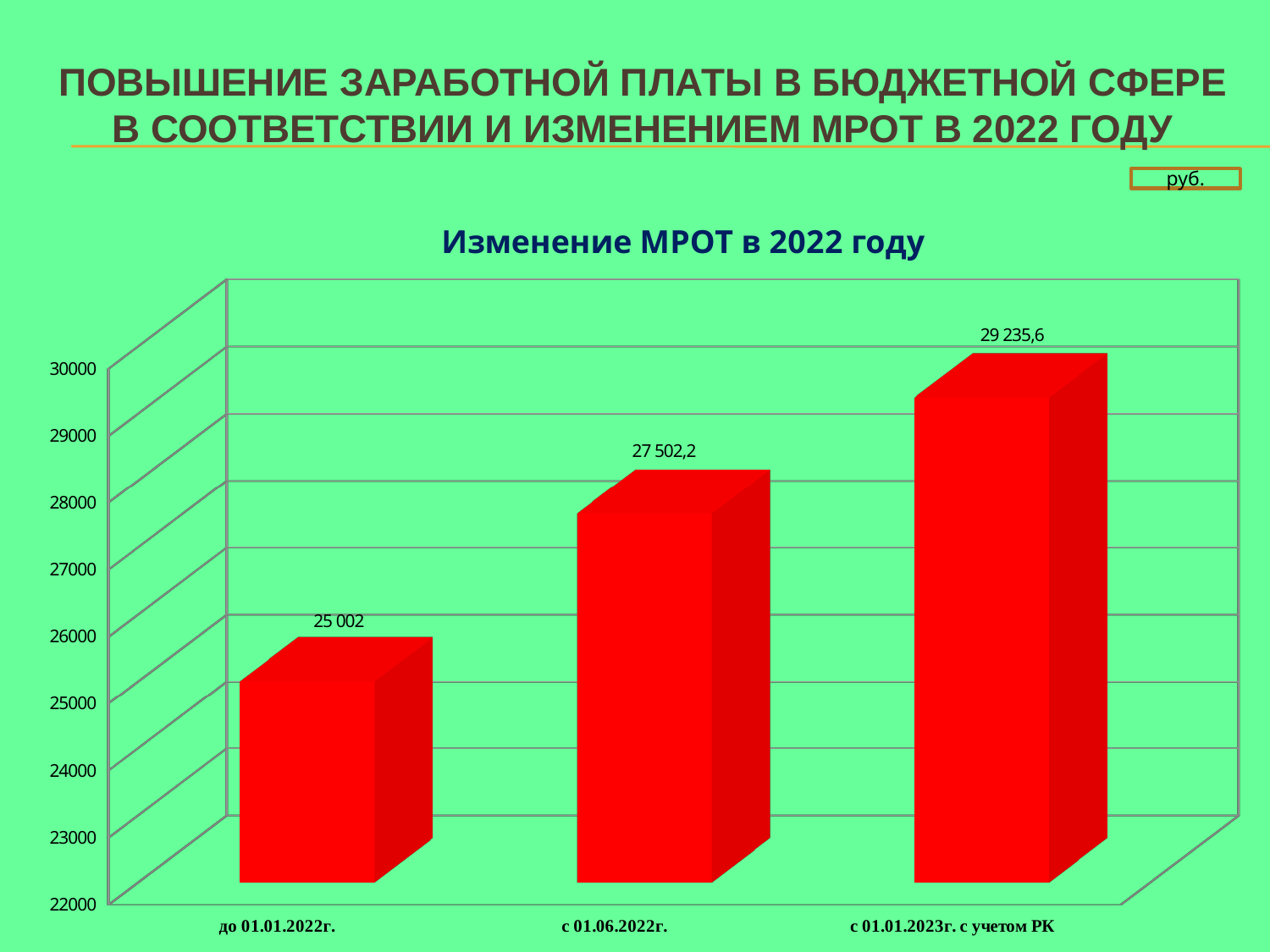
What is the difference between the values for "с 01.01.2023г. с учетом РК" and "с 01.06.2022г."? 1 733,4 What is the value for "с 01.01.2023г. с учетом РК" in the chart? 29 235,6 What type of chart is shown on the slide? bar chart What is the difference between the values for "с 01.06.2022г." and "до 01.01.2022г."? 2 500,2 Is the value for "с 01.01.2023г. с учетом РК" greater or less than 29000? greater What is the value for "с 01.06.2022г." in the chart? 27 502,2 Which is larger: the value for "с 01.06.2022г." or the value for "до 01.01.2022г."? с 01.06.2022г. Which category has the lowest value in the chart? до 01.01.2022г. What is the value for "до 01.01.2022г." in the chart "Изменение МРОТ в 2022 году"? 25 002 How many bars are shown in the chart? 3 Do the values rise or fall from left to right across the categories? rise Which category has the highest value in the chart? с 01.01.2023г. с учетом РК